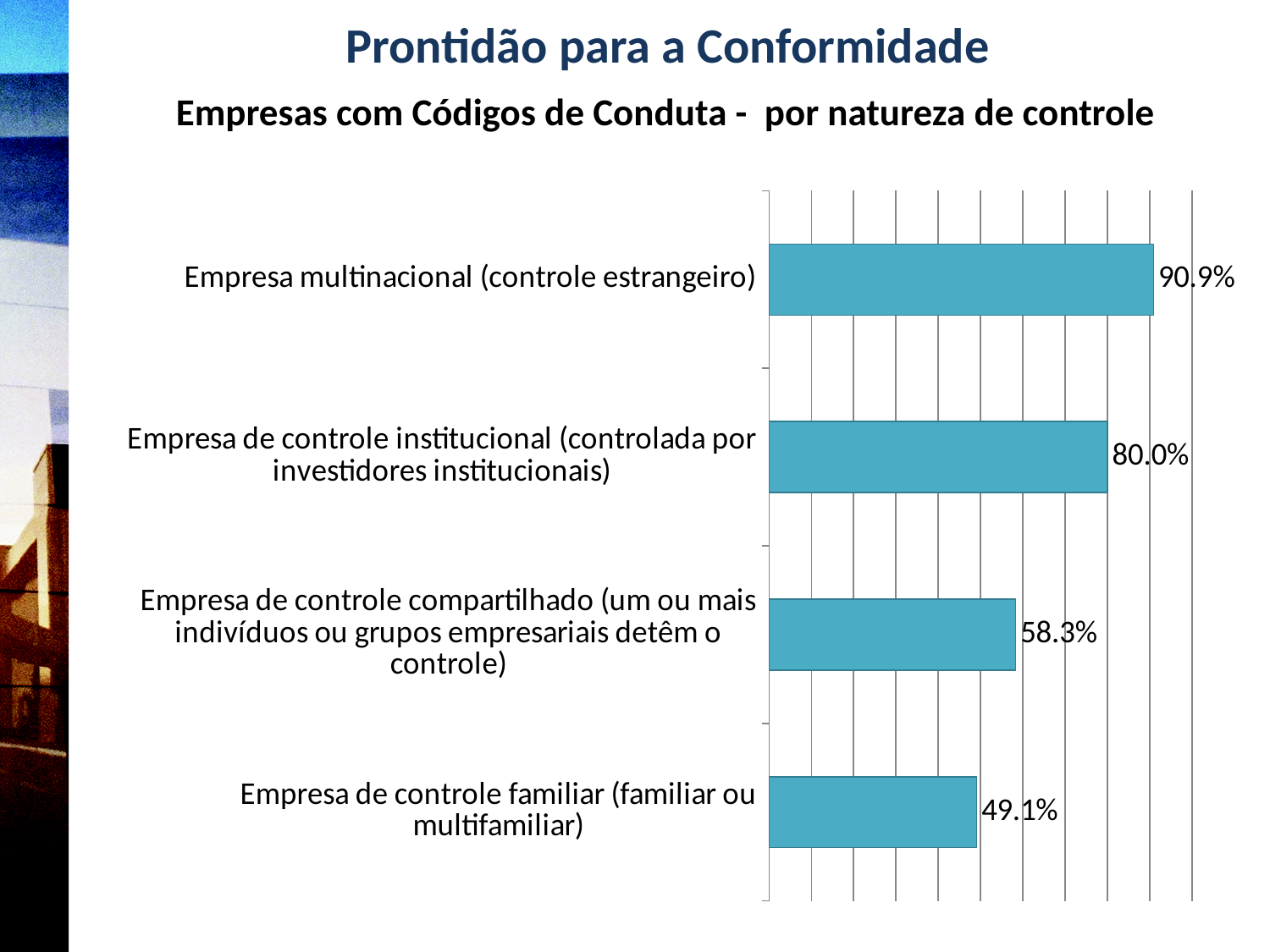
What is the value shown for 'Empresa de controle institucional'? 80.0% What is the value shown for 'Empresa de controle compartilhado'? 58.3% How many categories of company control are shown in the chart? 4 Which type of company has the lowest share with codes of conduct? Empresa de controle familiar (familiar ou multifamiliar) What is the difference in percentage points between 'Empresa multinacional' and 'Empresa de controle institucional'? 10.9 percentage points What kind of chart is shown on the slide? Bar chart What is the difference in percentage points between 'Empresa de controle compartilhado' and 'Empresa de controle familiar'? 9.2 percentage points What percentage of multinational companies (controle estrangeiro) have codes of conduct? 90.9% Which type of company has the highest share with codes of conduct? Empresa multinacional (controle estrangeiro) What is the value shown for 'Empresa de controle familiar'? 49.1% What is the subtitle of the chart on the slide? Empresas com Códigos de Conduta - por natureza de controle Which has a higher value: 'Empresa de controle institucional' or 'Empresa de controle compartilhado'? Empresa de controle institucional